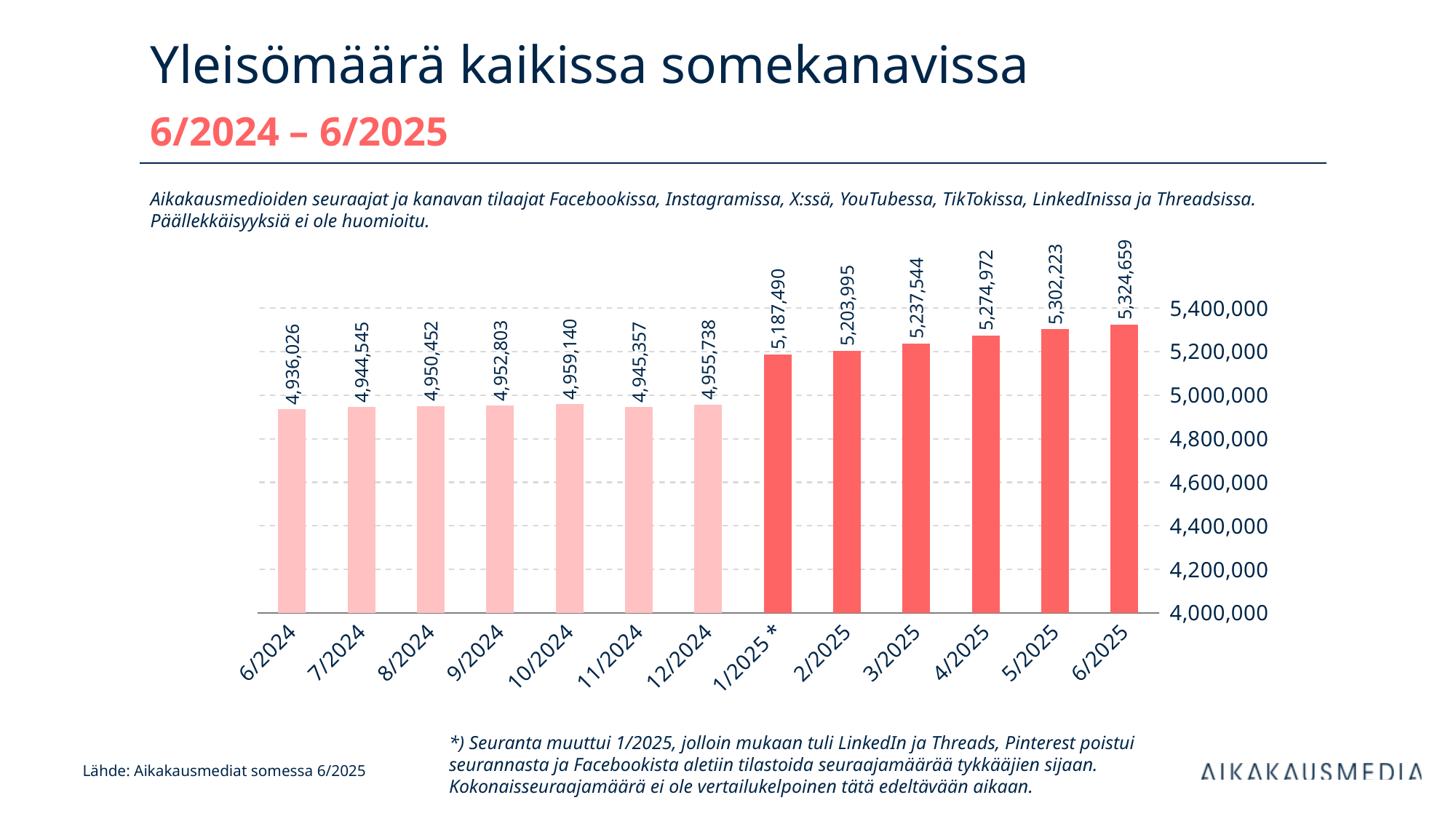
What is the difference between the values for 6/2025 and 6/2024? 388,633 Do the values generally rise or fall from 6/2024 to 6/2025? rise Is the value for 3/2025 greater or less than 5,200,000? greater What is the value for 1/2025 *? 5,187,490 Which month has the highest value? 6/2025 What is the difference between the values for 1/2025 * and 12/2024? 231,752 What is the value for 10/2024? 4,959,140 Which month has the lowest value? 6/2024 Which is larger, the value for 10/2024 or the value for 11/2024? 10/2024 How many months are shown on the x axis? 13 What is the value for 6/2025? 5,324,659 What kind of chart is shown on the slide? bar chart